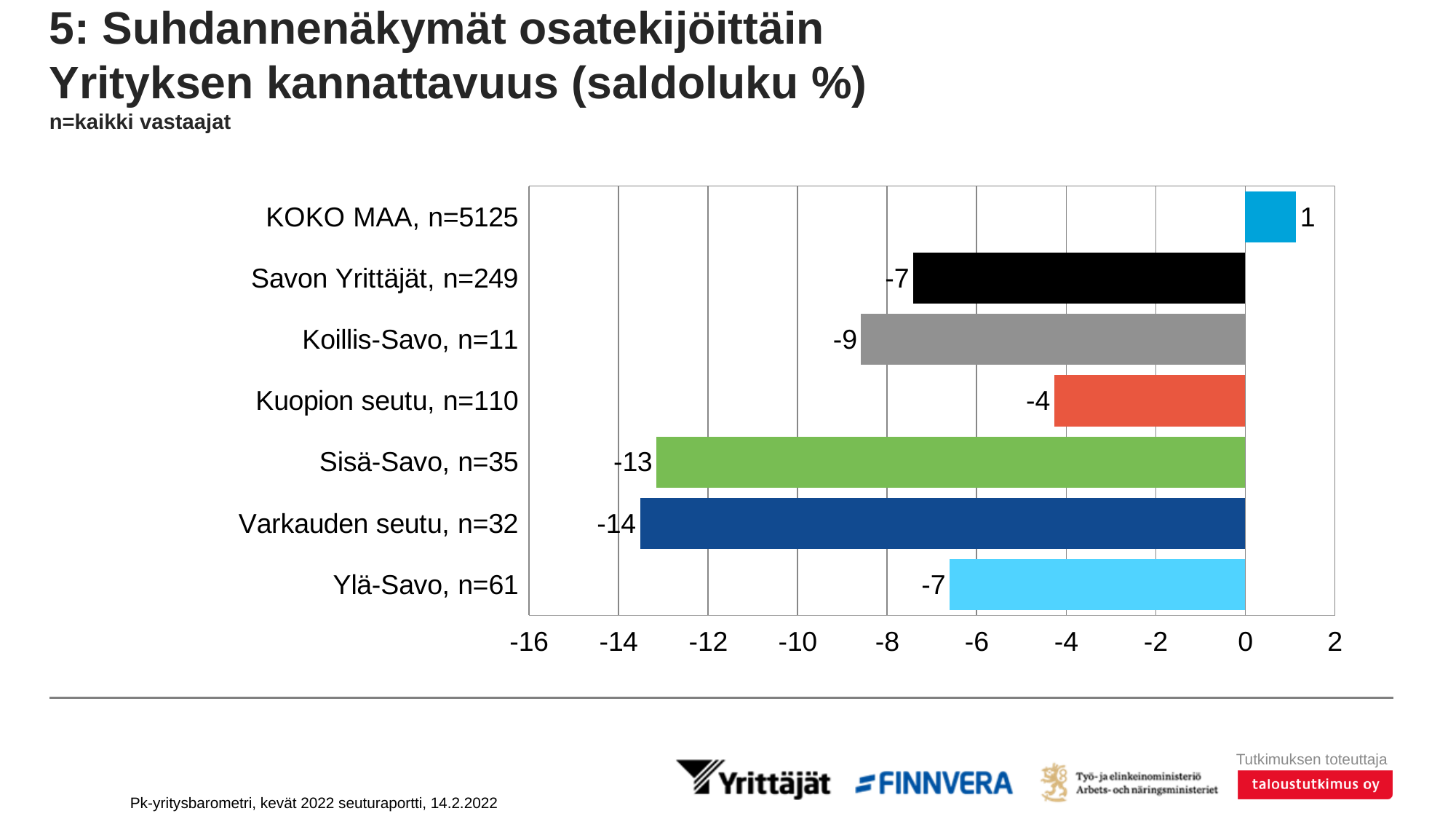
What is the value for KOKO MAA, n=5125? 1 What is the value for Koillis-Savo, n=11? -9 What is the value for Varkauden seutu, n=32? -14 What is the value for Savon Yrittäjät, n=249? -7 Which category has the lowest value? Varkauden seutu, n=32 What is the value for Kuopion seutu, n=110? -4 Which is larger, the value for Koillis-Savo, n=11 or the value for Ylä-Savo, n=61? Ylä-Savo, n=61 What kind of chart is shown on the slide? Bar chart Which category has the highest value? KOKO MAA, n=5125 What is the difference between the values for Sisä-Savo, n=35 and Kuopion seutu, n=110? 9 What colour is the bar for Sisä-Savo, n=35? Green How many categories are shown in the chart? 7